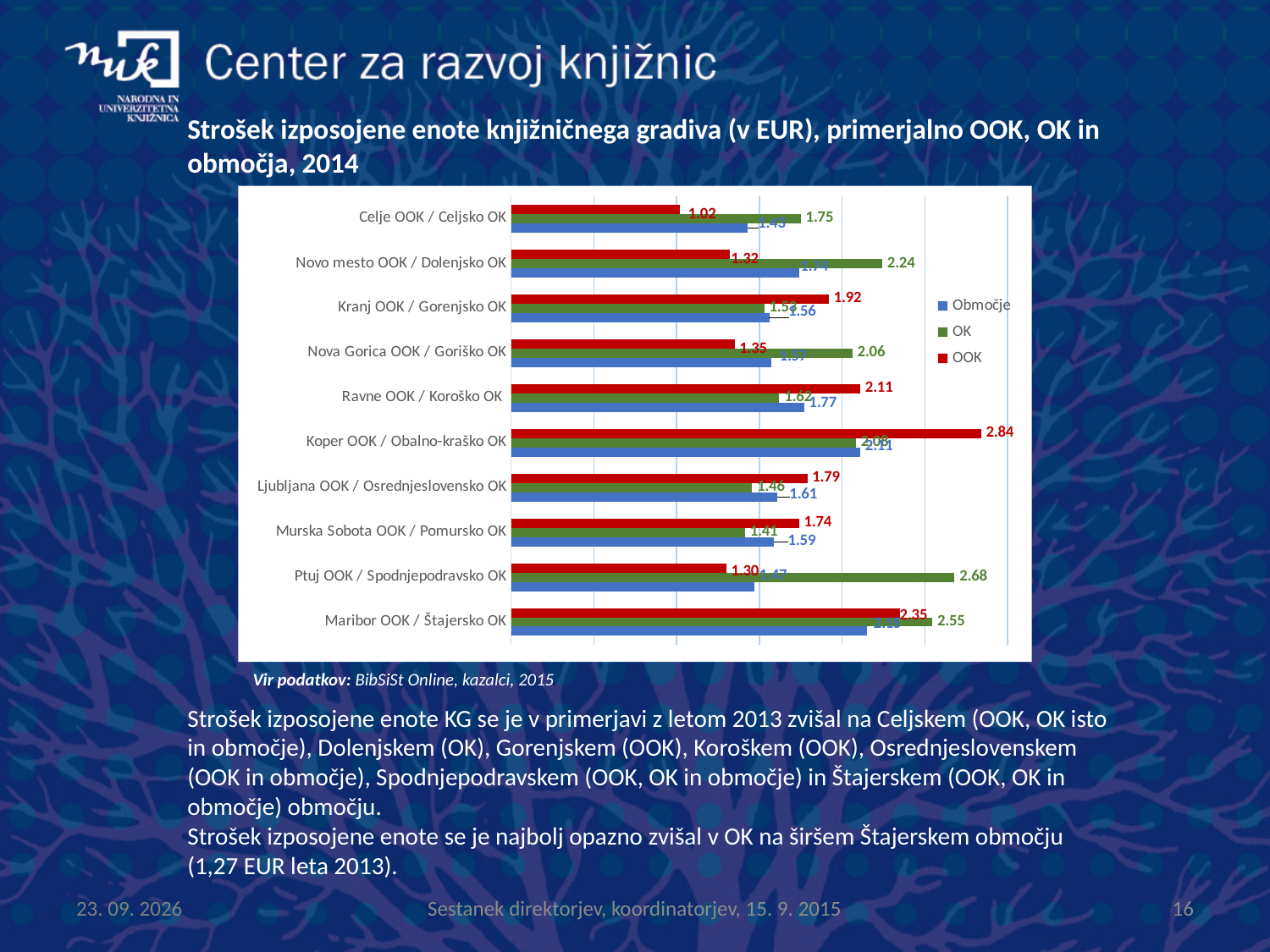
What is the Območje value for Ljubljana OOK / Osrednjeslovensko OK? 1.61 Which category has the highest OOK value? Koper OOK / Obalno-kraško OK What are the three series listed in the legend? Območje, OK, OOK What is the OK value for Ptuj OOK / Spodnjepodravsko OK? 2.68 What is the OOK value for Celje OOK / Celjsko OK? 1.02 How many categories are shown on the chart? 10 What kind of chart is shown on the slide? Bar chart How many series does the legend list? 3 What is the difference between the OK and OOK values for Maribor OOK / Štajersko OK? 0.20 Which category has the lowest OOK value? Celje OOK / Celjsko OK What is the difference between the OOK and Območje values for Ravne OOK / Koroško OK? 0.34 For Kranj OOK / Gorenjsko OK, which is larger: the OOK value or the OK value? OOK